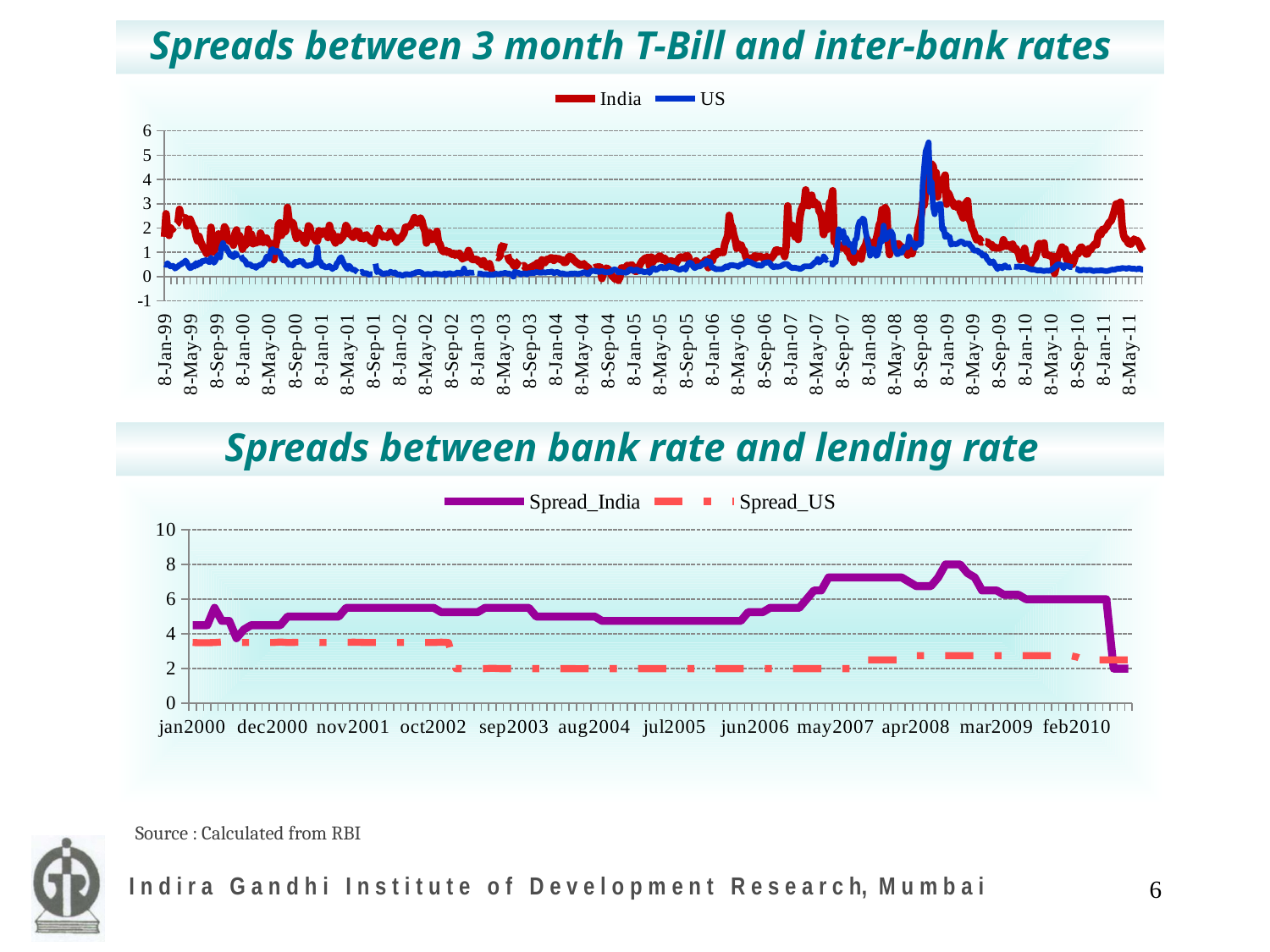
In the 'Spreads between 3 month T-Bill and inter-bank rates' chart, is the US value at 8-Jan-03 greater or less than 1? less In the 'Spreads between 3 month T-Bill and inter-bank rates' chart, which series is higher at 8-Jan-99, India or US? India In the 'Spreads between bank rate and lending rate' chart, is the Spread_India value at jan2000 greater or less than 4? greater In the 'Spreads between 3 month T-Bill and inter-bank rates' chart, is the peak value of the US series around 8-Sep-08 greater or less than 5? greater In the 'Spreads between 3 month T-Bill and inter-bank rates' chart, which series reaches the higher peak around 8-Sep-08, India or US? US In the 'Spreads between bank rate and lending rate' chart, which series is higher at jan2000, Spread_India or Spread_US? Spread_India What kind of chart is the 'Spreads between bank rate and lending rate' chart? line chart How many series does the legend of the 'Spreads between bank rate and lending rate' chart list? 2 In the 'Spreads between 3 month T-Bill and inter-bank rates' chart, which series is drawn in red? India How many series does the legend of the 'Spreads between 3 month T-Bill and inter-bank rates' chart list? 2 What kind of chart is the 'Spreads between 3 month T-Bill and inter-bank rates' chart? line chart